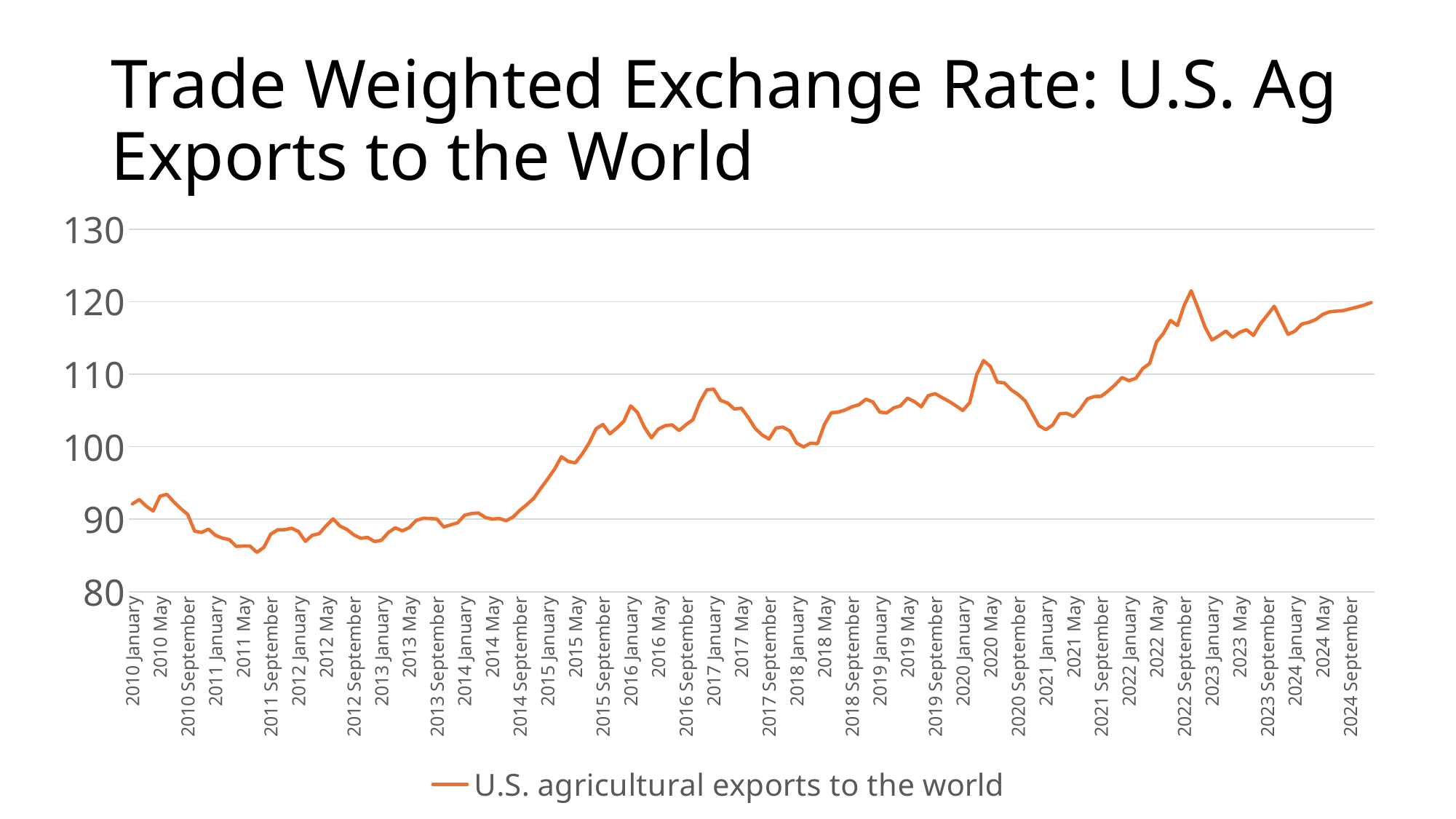
Which is larger, the value for 2011 May or the value for 2022 September? 2022 September How many series does the legend list? 1 Is the value for 2024 September greater or less than 110? greater What is the title of the chart? Trade Weighted Exchange Rate: U.S. Ag Exports to the World Is the value for 2017 January greater or less than 100? greater What kind of chart is shown on the slide? line chart Which is larger, the value for 2010 January or the value for 2024 September? 2024 September Is the value for 2010 January greater or less than 100? less Overall, do the values rise or fall from 2010 January to 2024 September? rise What is the legend entry for the plotted line? U.S. agricultural exports to the world